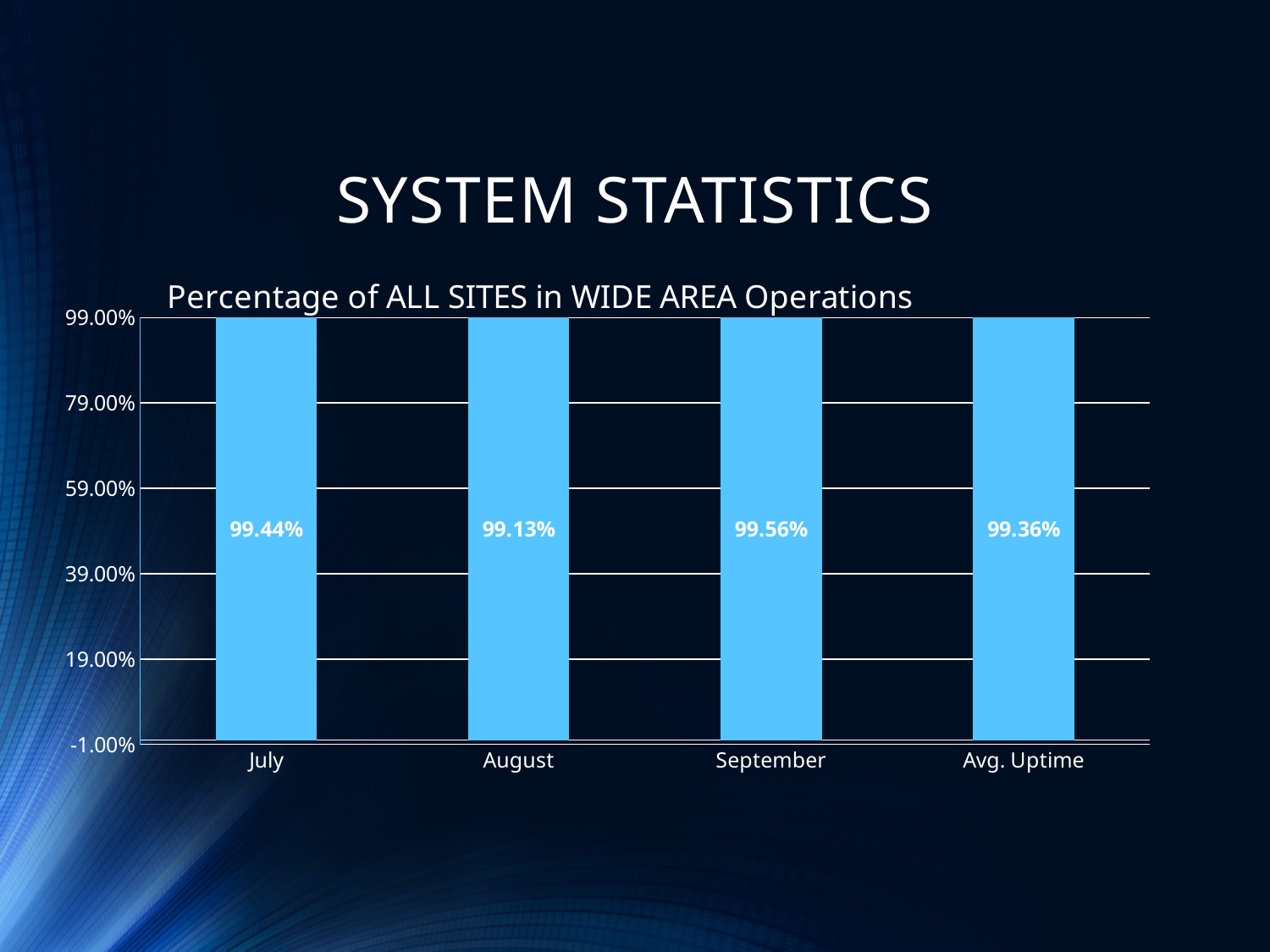
Which category has the highest value? September What is the value for August? 99.13% What is the difference between the values for September and August? 0.43% What is the value for September? 99.56% What kind of chart is shown? bar chart What is the value for Avg. Uptime? 99.36% Which category has the lowest value? August How many categories are shown on the x axis? 4 What is the title of the chart? Percentage of ALL SITES in WIDE AREA Operations Which is larger, the value for July or the value for Avg. Uptime? July Is the value for August greater or less than 79.00%? greater What is the value for July? 99.44%